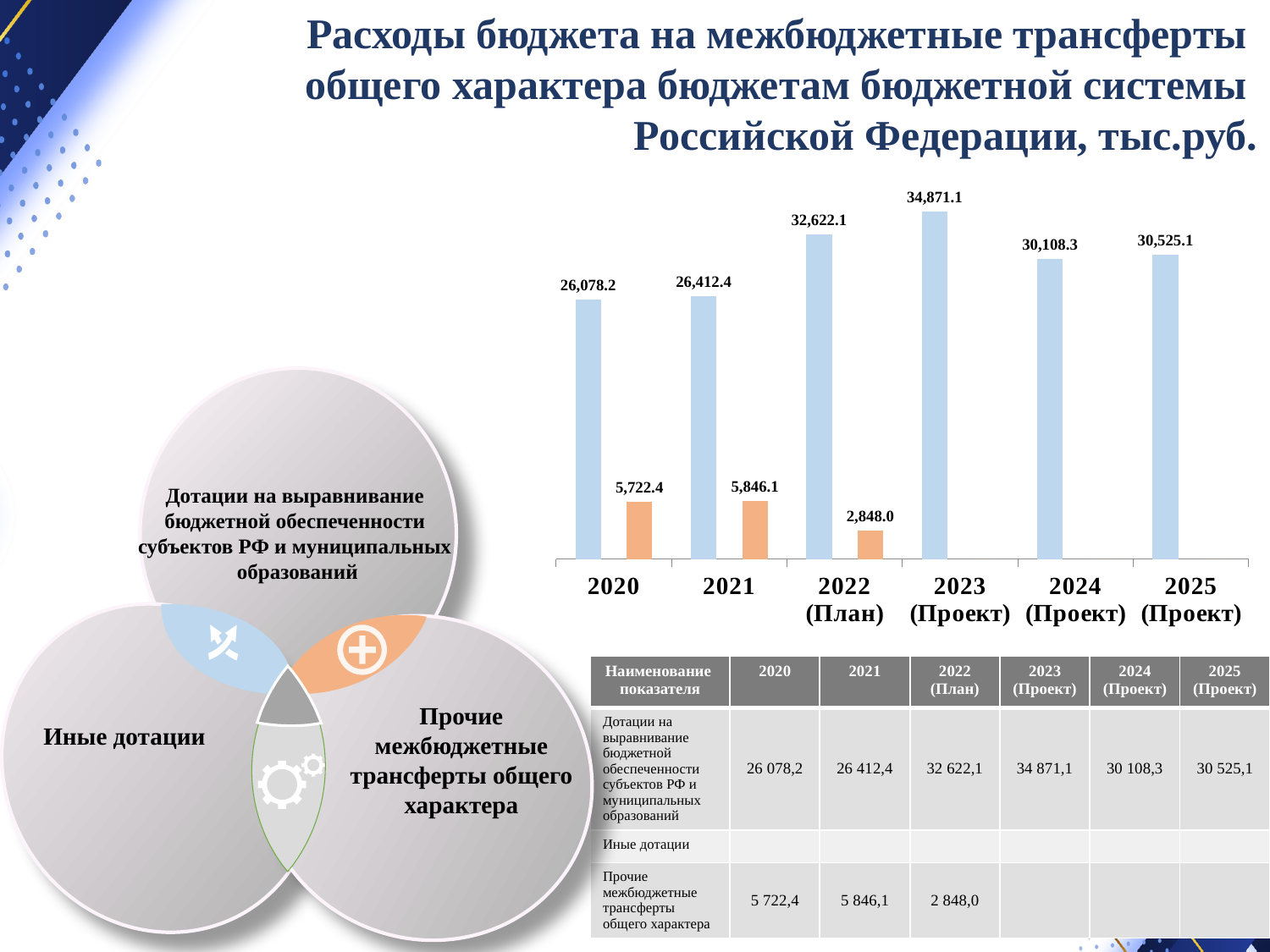
Which is larger, the blue bar for 2024 (Проект) or the blue bar for 2025 (Проект)? 2025 (Проект) What is the value of the orange bar for 2020? 5,722.4 What is the value of the blue bar for 2023 (Проект)? 34,871.1 How many years are shown on the x axis of the chart? 6 In which year is the blue bar highest? 2023 (Проект) What type of chart is shown on the slide? Bar chart What is the difference between the blue bar values for 2023 (Проект) and 2022 (План)? 2,249.0 In which year is the orange bar lowest? 2022 (План) What is the difference between the orange bar values for 2021 and 2020? 123.7 What is the value of the blue bar for 2025 (Проект)? 30,525.1 In which year is the blue bar lowest? 2020 What is the value of the orange bar for 2022 (План)? 2,848.0